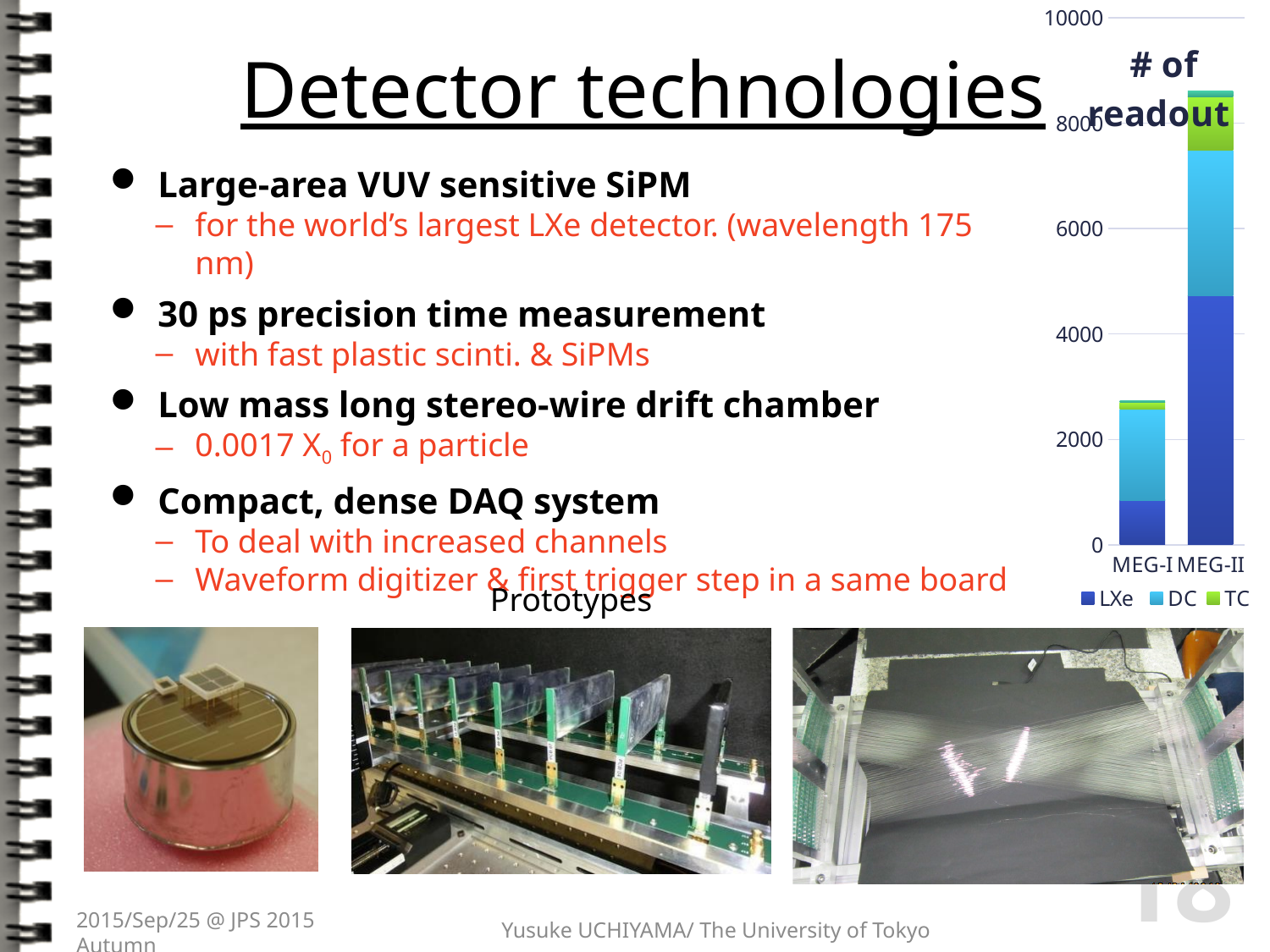
Is the total height of the MEG-II bar greater or less than 8000? greater What is the title of the chart? # of readout How many series does the chart legend list? 3 Which category has the shorter stacked bar? MEG-I How many categories are shown on the x axis of the chart? 2 What kind of chart is shown on the slide? stacked bar chart Is the LXe value for MEG-II greater or less than 4000? greater Is the LXe value for MEG-I greater or less than 2000? less Which is larger, the LXe value for MEG-I or the LXe value for MEG-II? MEG-II Which category has the taller stacked bar, MEG-I or MEG-II? MEG-II Which series are listed in the chart legend? LXe, DC, TC